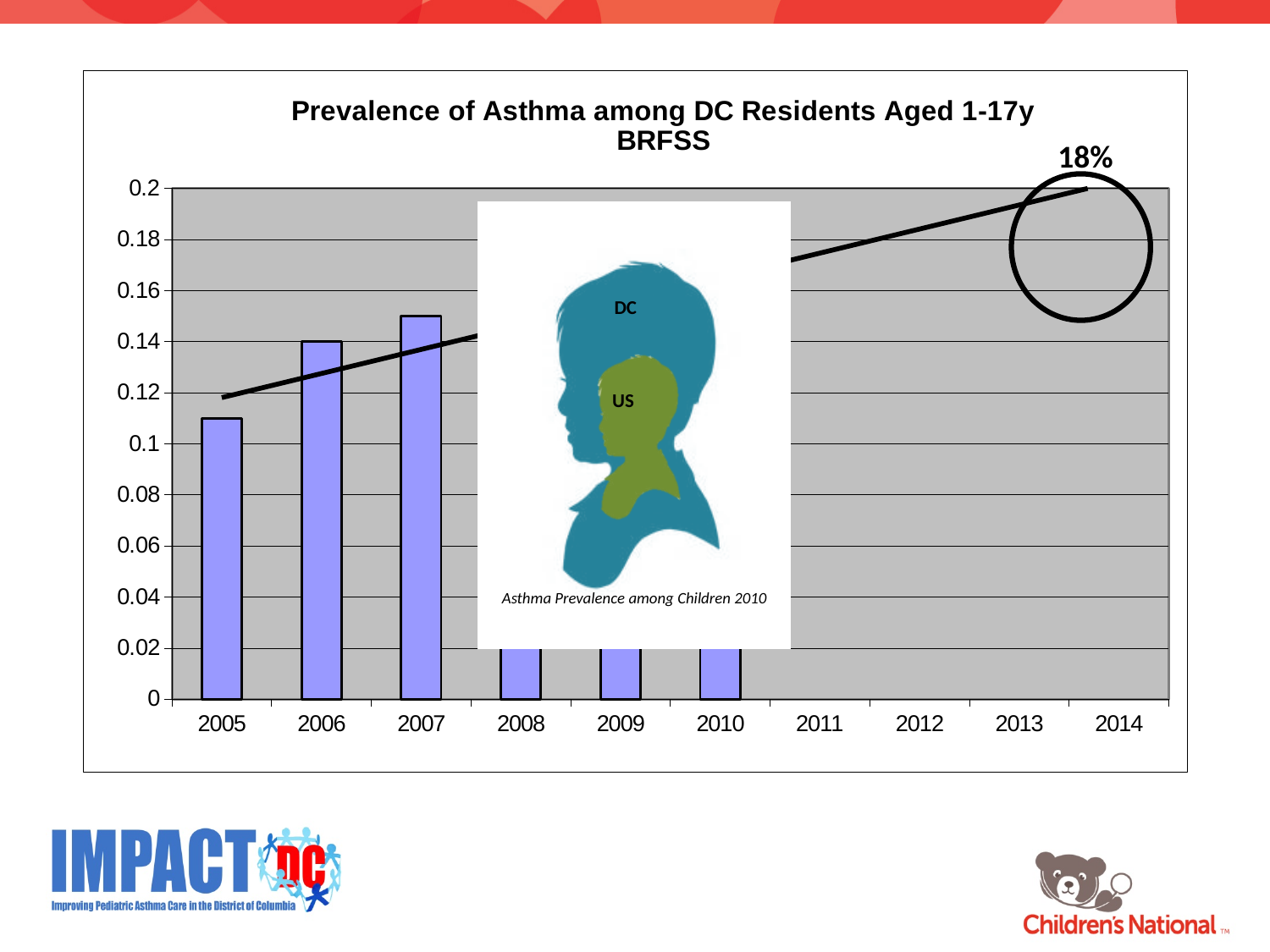
Do the bar values rise or fall from 2005 to 2007? rise Is the value for 2007 greater or less than 0.14? greater Among 2005, 2006 and 2007, which year has the tallest bar? 2007 What is the title of the chart? Prevalence of Asthma among DC Residents Aged 1-17y BRFSS Is the value for 2007 greater or less than 0.16? less Is the value for 2005 greater or less than 0.1? greater Which is larger, the value for 2005 or the value for 2006? 2006 What kind of chart is shown on the slide? bar chart How many year labels are shown on the x axis? 10 Among 2005, 2006 and 2007, which year has the shortest bar? 2005 What is the value of the bar for 2006? 0.14